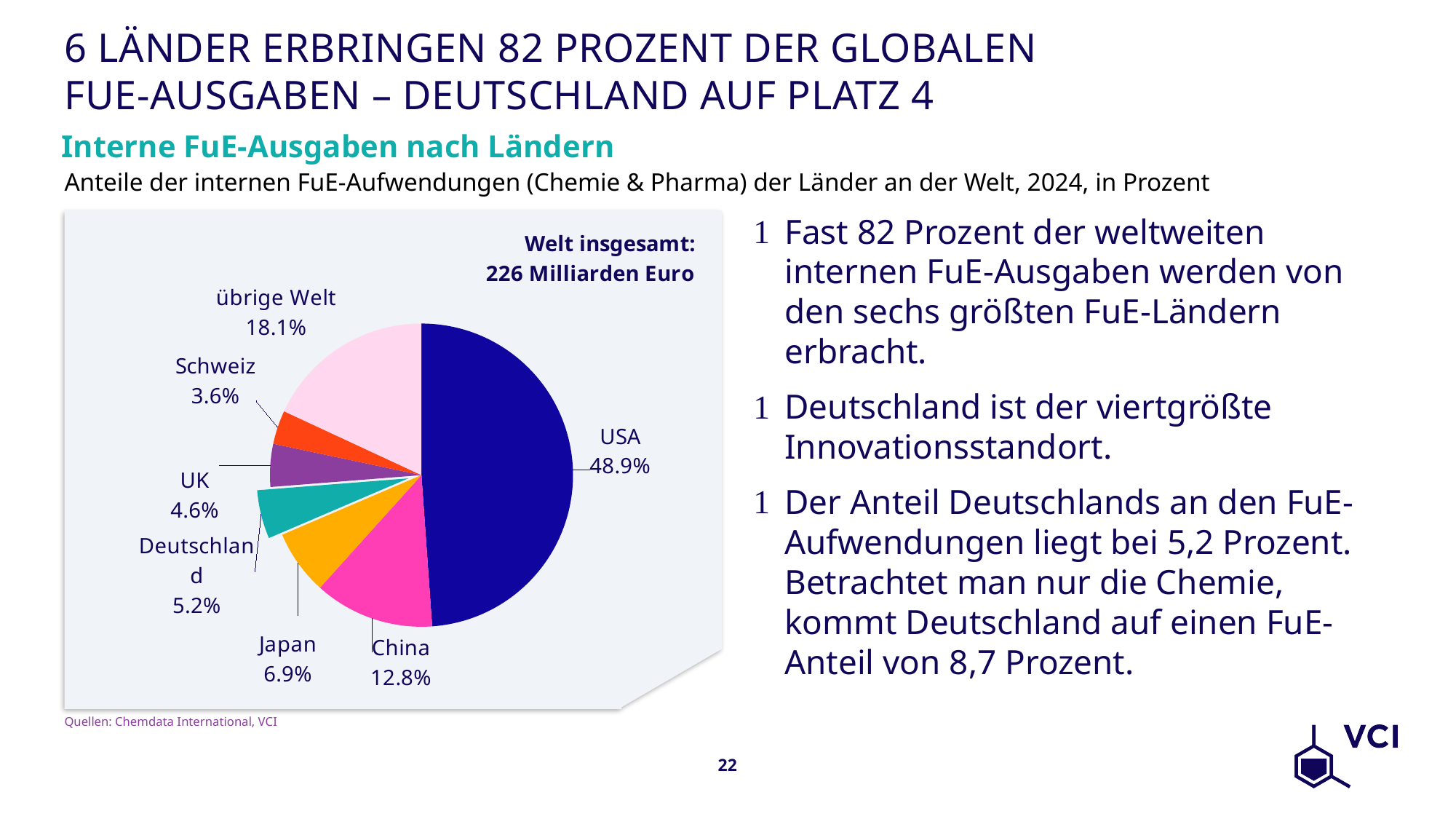
What type of chart is shown on the slide? Pie chart What share of the pie does USA hold? 48.9% How many slices does the pie chart have? 7 What total world value is stated in the chart? 226 Milliarden Euro What is the value shown for Schweiz? 3.6% What is the value shown for China? 12.8% Which labelled slice is the smallest? Schweiz What is the value shown for Deutschland? 5.2% Which country has the largest slice of the pie? USA What is the difference between the shares of Japan and UK? 2.3% What is the combined share of USA and China? 61.7% Which is larger, the share of UK or the share of Deutschland? Deutschland